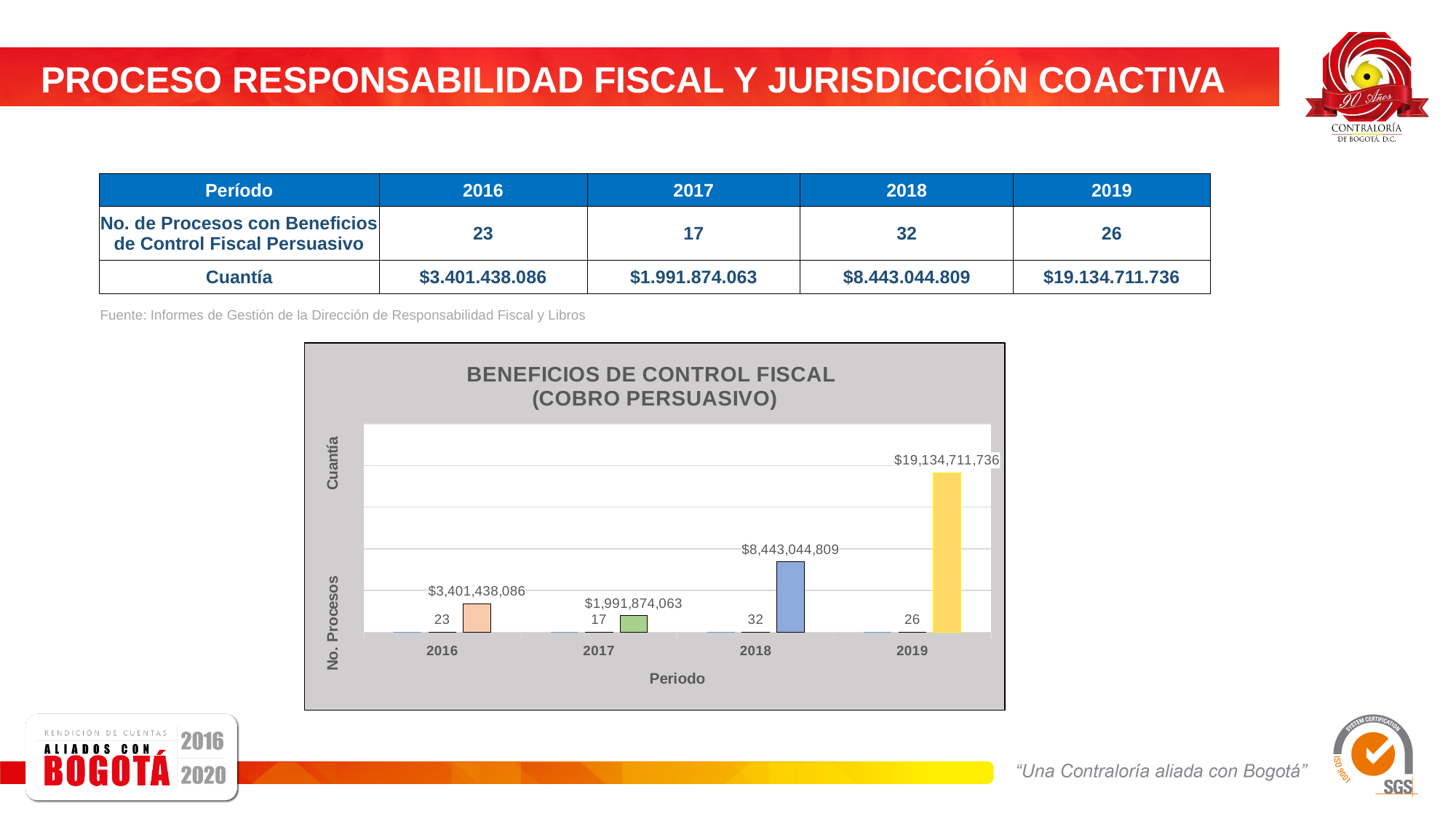
Which year has the lowest number of processes in the chart? 2017 What is the difference in the number of processes between 2018 and 2016? 9 What is the title of the chart? BENEFICIOS DE CONTROL FISCAL (COBRO PERSUASIVO) What is the Cuantía value shown for 2017 in the chart? $1,991,874,063 Which year has the larger Cuantía, 2016 or 2018? 2018 How many processes (No. Procesos) are shown for 2016 in the chart? 23 What is the difference in Cuantía between 2019 and 2018? $10,691,666,927 Which year has the highest Cuantía in the chart? 2019 How many processes (No. Procesos) are shown for 2018 in the chart? 32 What type of chart is shown on the slide? Bar chart How many years (periods) are shown on the x axis of the chart? 4 What is the Cuantía value shown for 2019 in the chart? $19,134,711,736